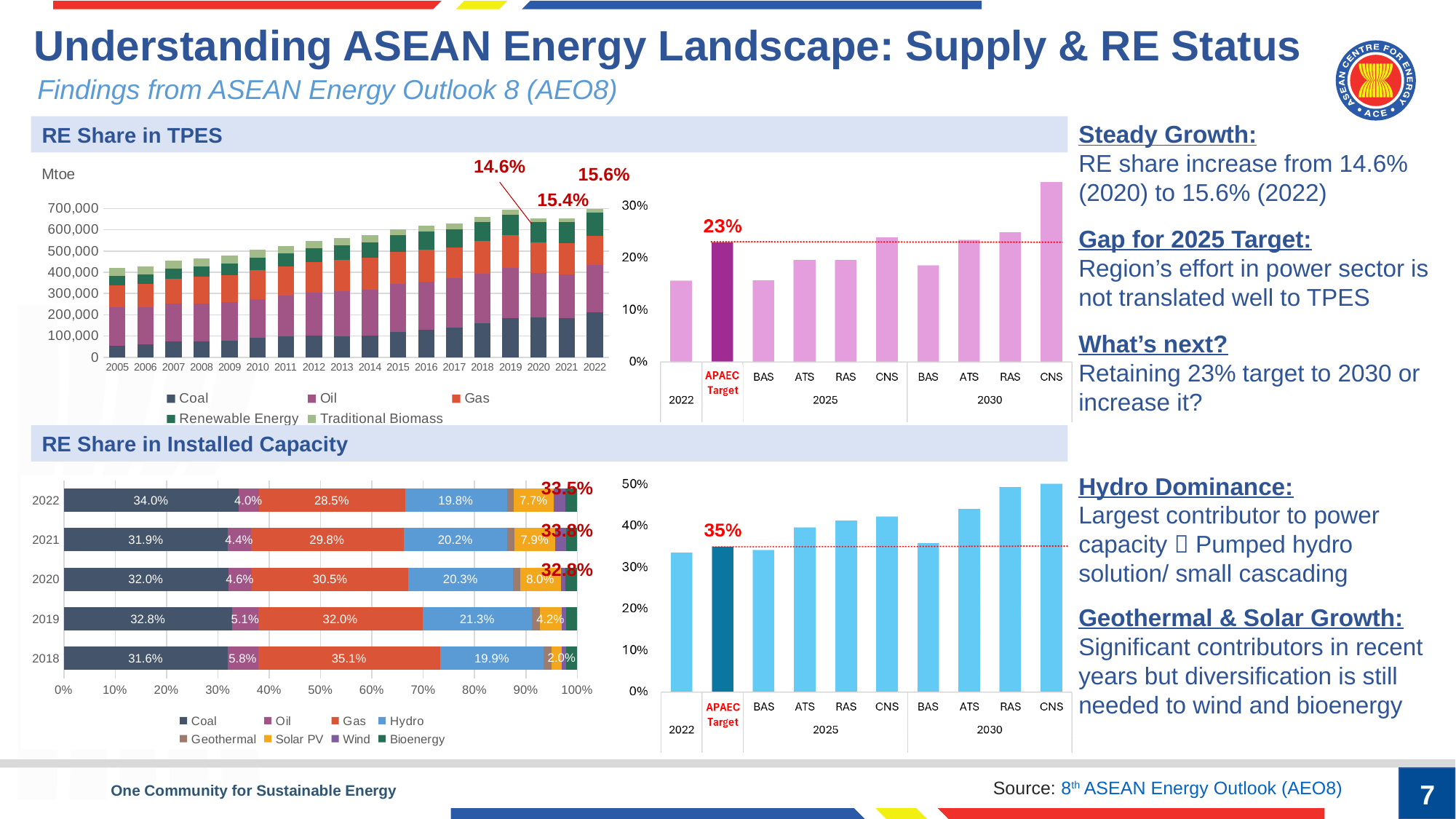
In the top-right bar chart of RE share in TPES scenarios, what value is labelled for the APAEC Target? 23% In the bottom-left horizontal stacked bar chart (RE Share in Installed Capacity), what is the difference between the Gas share in 2018 and in 2022? 6.6% In the bottom-right bar chart of RE share in installed capacity scenarios, what value is labelled for the APAEC Target? 35% In the top-left stacked bar chart (RE Share in TPES), does total supply rise or fall from 2005 to 2022? rise In the top-right bar chart of RE share in TPES scenarios, is the value for 2022 greater or less than 20%? less In the bottom-left horizontal stacked bar chart (RE Share in Installed Capacity), what is the Hydro share in 2019? 21.3% In the top-right bar chart of RE share in TPES scenarios, which bar is the highest? 2030 CNS In the top-left stacked bar chart (RE Share in TPES), what RE share is labelled for 2020? 14.6% In the top-left stacked bar chart (RE Share in TPES), how many series does the legend list? 5 In the top-left stacked bar chart (RE Share in TPES), how many years are shown on the x axis? 18 In the top-left stacked bar chart (RE Share in TPES), what RE share is labelled for 2022? 15.6% In the bottom-left horizontal stacked bar chart (RE Share in Installed Capacity), what is the Coal share in 2022? 34.0%